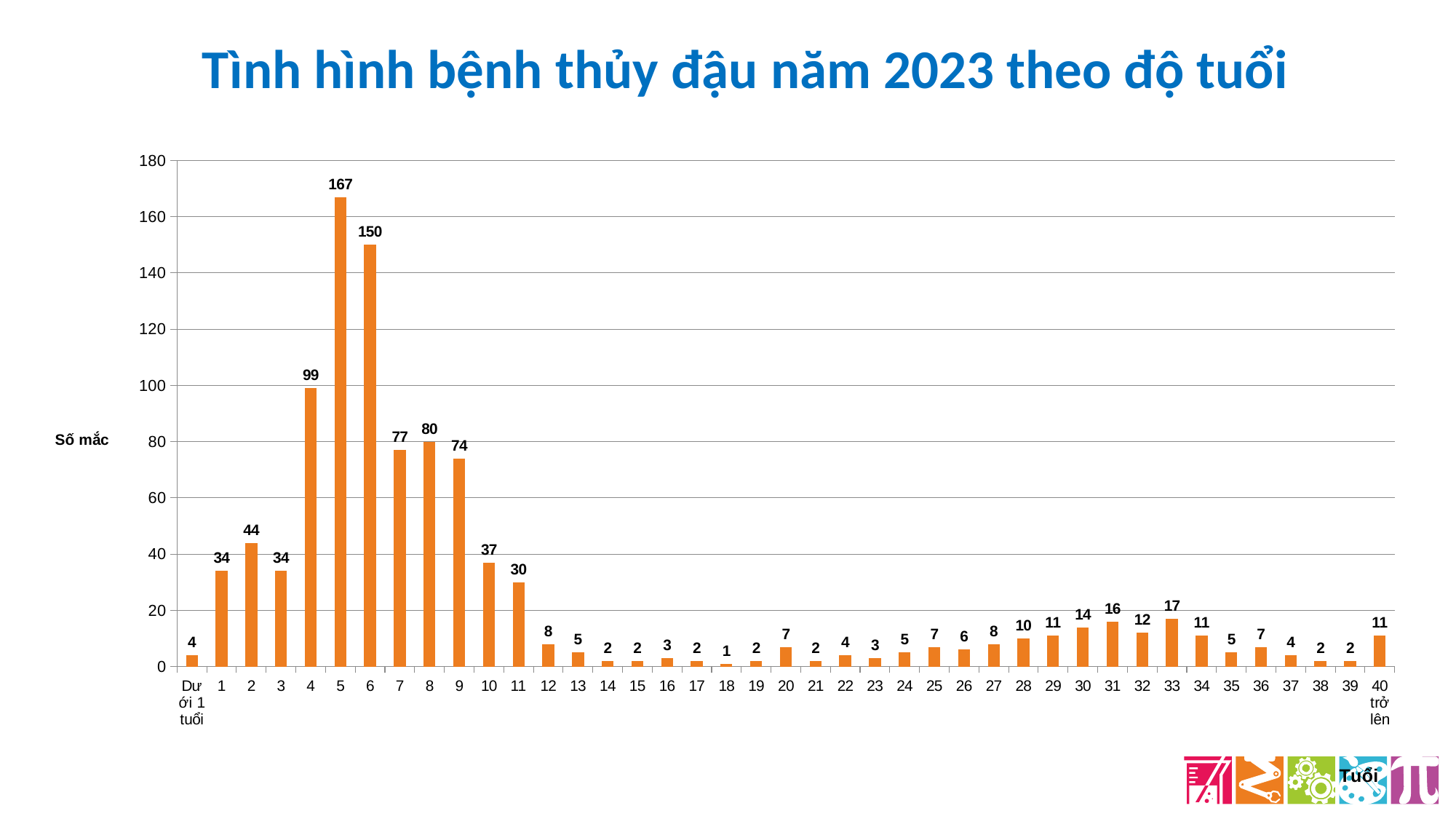
Which age category has the highest value? 5 How many age categories are shown on the x axis? 41 What is the title of the chart? Tình hình bệnh thủy đậu năm 2023 theo độ tuổi What is the value for age 5? 167 What is the value for age 6? 150 Is the value for age 4 greater or less than 80? greater What kind of chart is shown on the slide? bar chart What is the value for the category '40 trở lên'? 11 What is the value for the category 'Dưới 1 tuổi'? 4 Which is larger, the value for age 8 or the value for age 9? age 8 Which age category has the lowest value? 18 What is the difference between the values for age 5 and age 6? 17